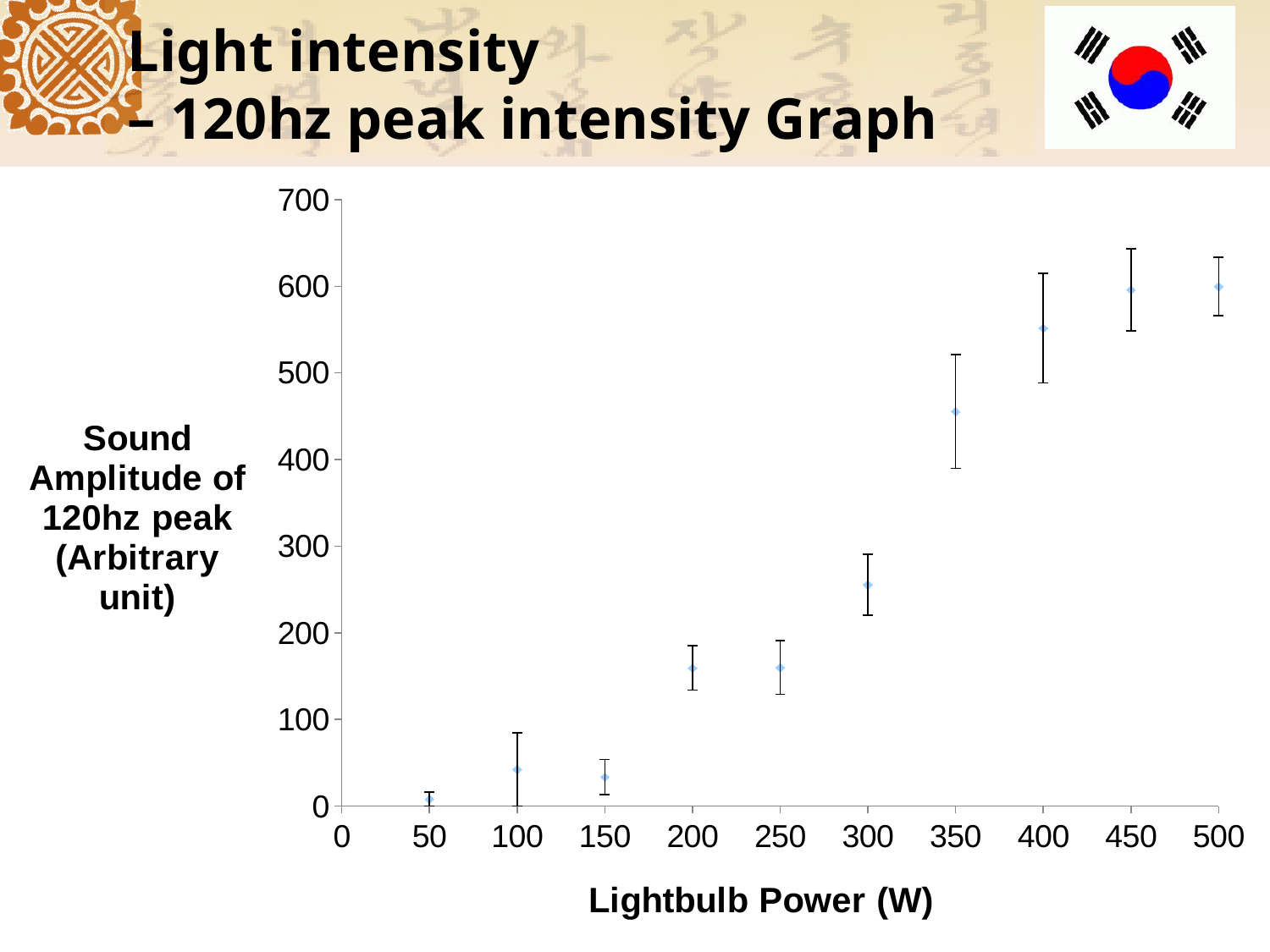
Is the sound amplitude at 200 W greater or less than 100? greater Is the sound amplitude at 100 W greater or less than 100? less What kind of chart is shown on the slide? Scatter chart At which lightbulb power is the sound amplitude lowest? 50 W What is the highest value shown on the y axis? 700 How many data points are plotted on the chart? 10 Do the sound amplitude values generally rise or fall as lightbulb power increases along the x axis? Rise Which has the larger sound amplitude, 300 W or 350 W? 350 W What is the label of the x axis? Lightbulb Power (W) Is the sound amplitude at 350 W greater or less than 400? greater